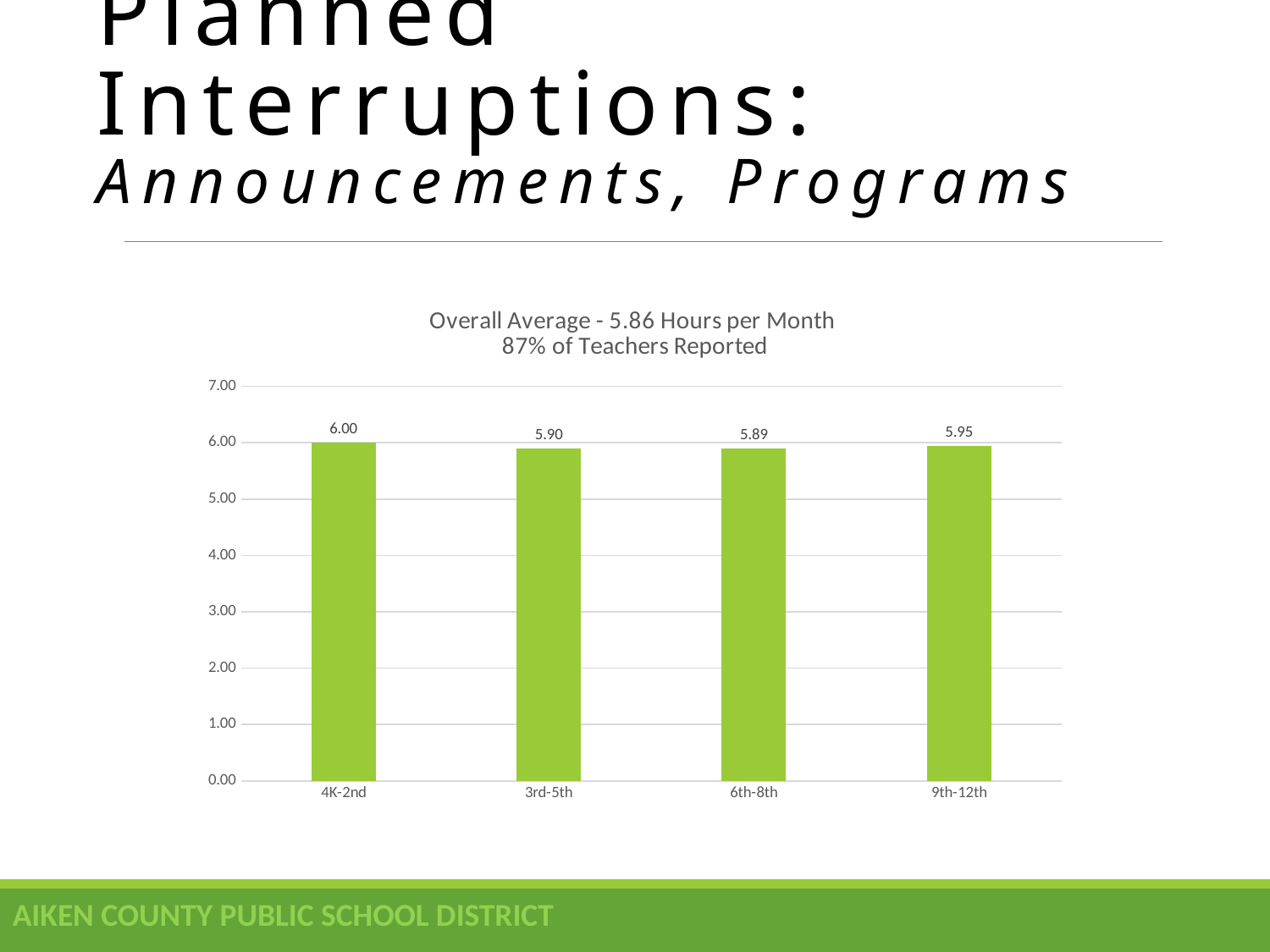
Which is larger, the value for 4K-2nd or the value for 9th-12th? 4K-2nd What is the chart's title? Overall Average - 5.86 Hours per Month 87% of Teachers Reported What is the value for 6th-8th? 5.89 What is the difference between the values for 9th-12th and 3rd-5th? 0.05 Which grade band has the lowest value? 6th-8th What kind of chart is shown on the slide? bar chart What is the value for 3rd-5th? 5.90 What is the value for 4K-2nd? 6.00 What is the difference between the values for 4K-2nd and 6th-8th? 0.11 How many grade bands are shown on the chart? 4 Which grade band has the highest value? 4K-2nd What is the value for 9th-12th? 5.95